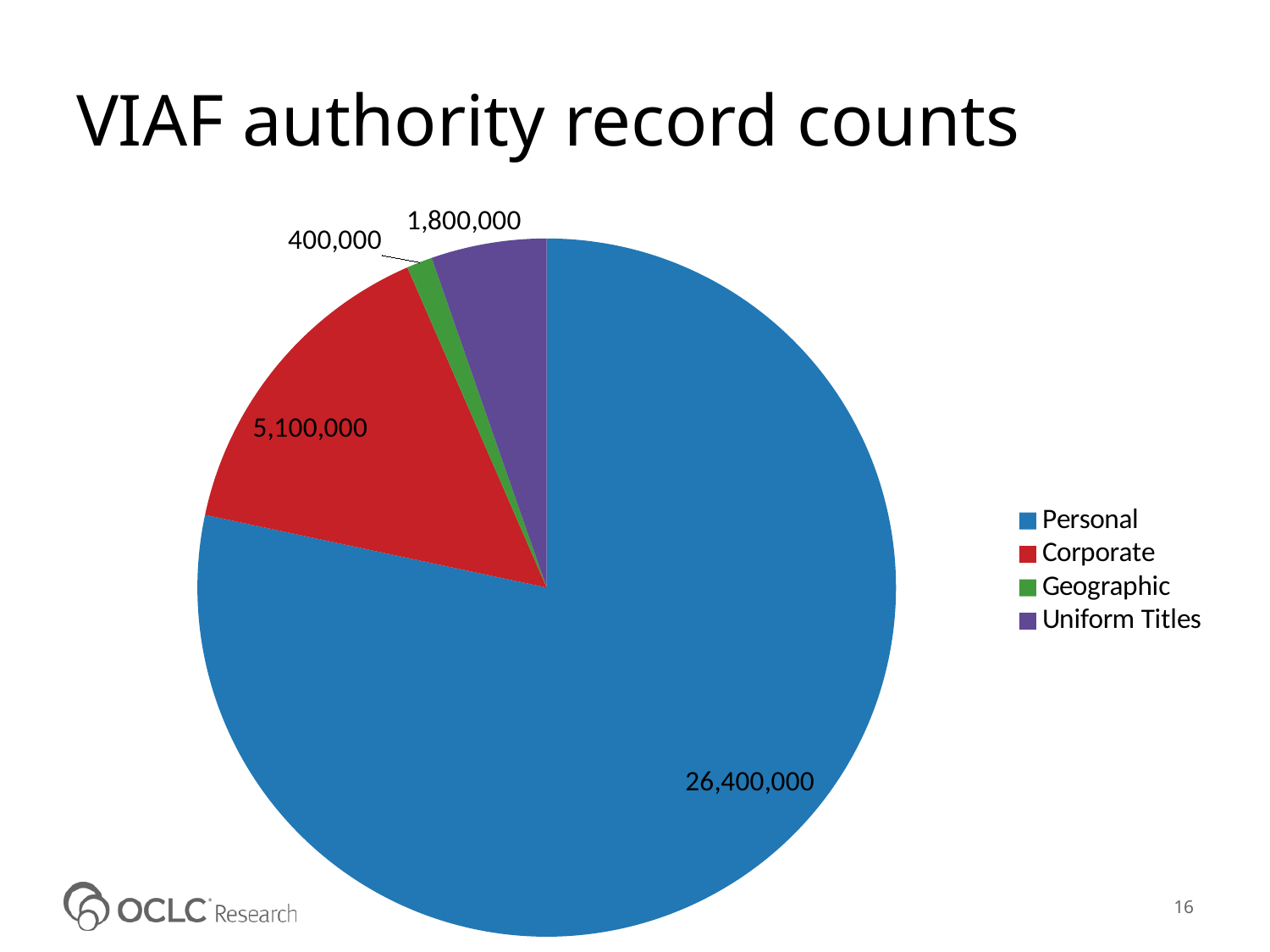
What is the value for Geographic in the pie chart? 400,000 How many categories does the pie chart show? 4 Which is larger, the value for Corporate or the value for Uniform Titles? Corporate What is the difference between the Uniform Titles and Geographic values? 1,400,000 What is the value for Corporate in the pie chart? 5,100,000 What is the difference between the Personal and Corporate values? 21,300,000 Which category has the smallest slice of the pie chart? Geographic What is the title of the chart on the slide? VIAF authority record counts What kind of chart is shown on the slide? Pie chart What is the value for Personal in the pie chart? 26,400,000 What is the value for Uniform Titles in the pie chart? 1,800,000 Which category has the largest slice of the pie chart? Personal